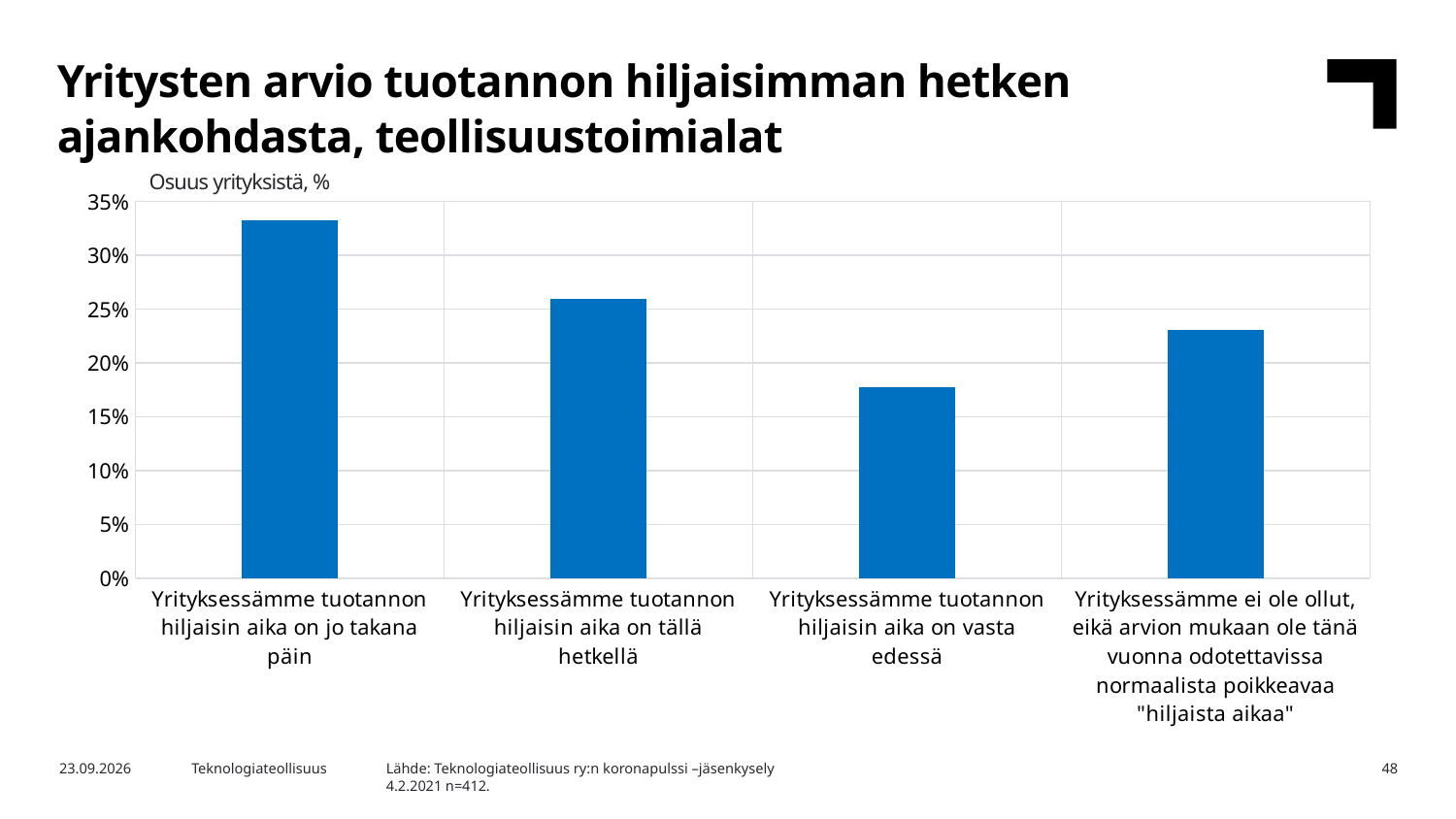
How many categories are shown on the x axis of the chart? 4 What kind of chart is shown on the slide? bar chart Which is larger: the value for "Yrityksessämme tuotannon hiljaisin aika on tällä hetkellä" or the value for "Yrityksessämme ei ole ollut, eikä arvion mukaan ole tänä vuonna odotettavissa normaalista poikkeavaa 'hiljaista aikaa'"? Yrityksessämme tuotannon hiljaisin aika on tällä hetkellä Which category has the lowest value? Yrityksessämme tuotannon hiljaisin aika on vasta edessä Which category has the highest value? Yrityksessämme tuotannon hiljaisin aika on jo takana päin Is the value for "Yrityksessämme ei ole ollut, eikä arvion mukaan ole tänä vuonna odotettavissa normaalista poikkeavaa 'hiljaista aikaa'" greater or less than 25%? less Is the value for "Yrityksessämme tuotannon hiljaisin aika on vasta edessä" greater or less than 20%? less Is the value for "Yrityksessämme tuotannon hiljaisin aika on tällä hetkellä" greater or less than 25%? greater Which is larger: the value for "Yrityksessämme tuotannon hiljaisin aika on vasta edessä" or the value for "Yrityksessämme tuotannon hiljaisin aika on jo takana päin"? Yrityksessämme tuotannon hiljaisin aika on jo takana päin What is the highest value shown on the y axis of the chart? 35% What is the label shown above the y axis of the chart? Osuus yrityksistä, %